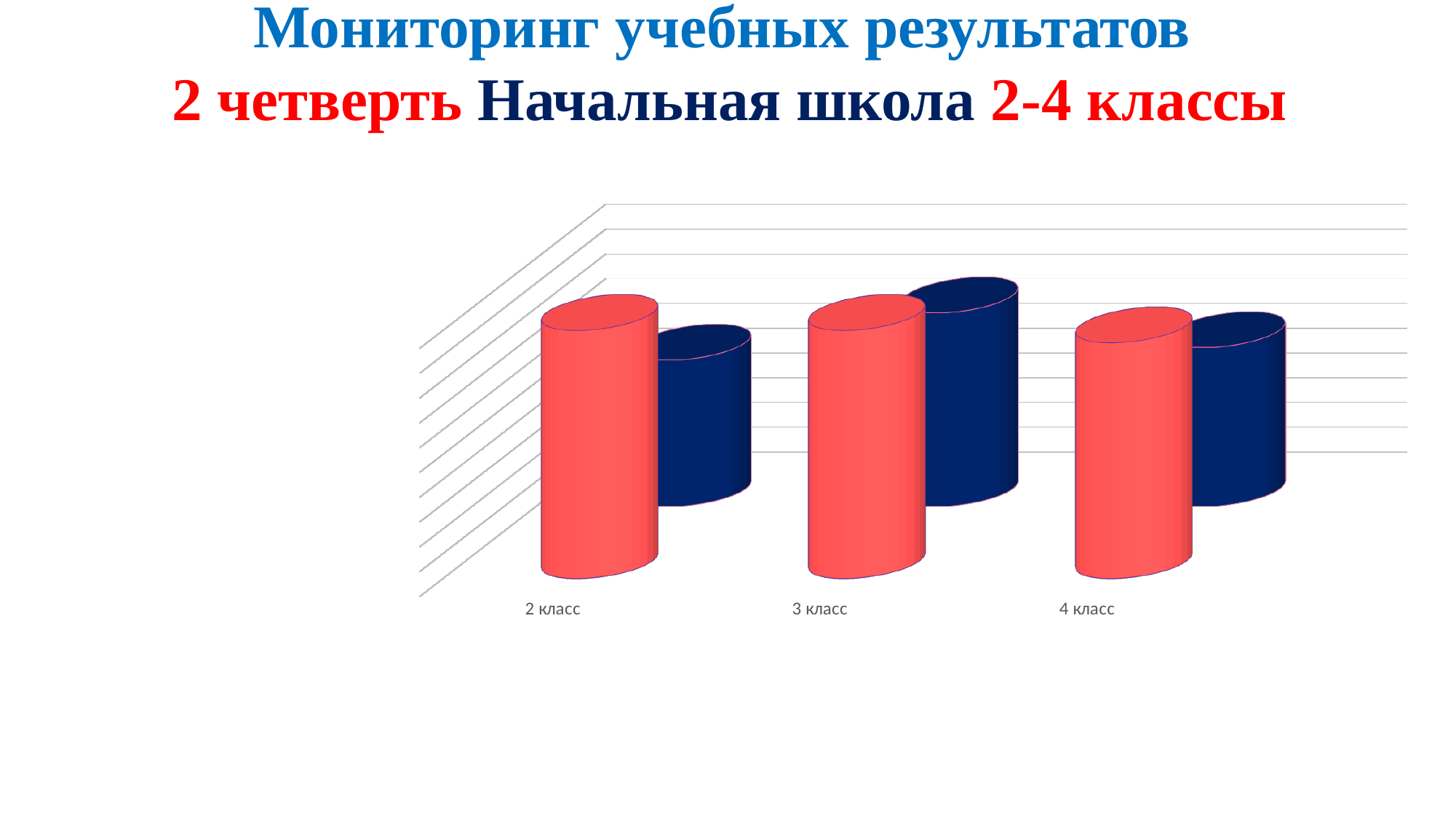
How many bars are plotted for each class category in the chart? 2 What two colours are used for the bars in the chart? red and dark blue What are the category labels on the x axis of the chart? 2 класс, 3 класс, 4 класс Which category has the tallest dark blue bar? 3 класс How many categories are shown on the x axis of the chart? 3 What kind of chart is shown on the slide? bar chart